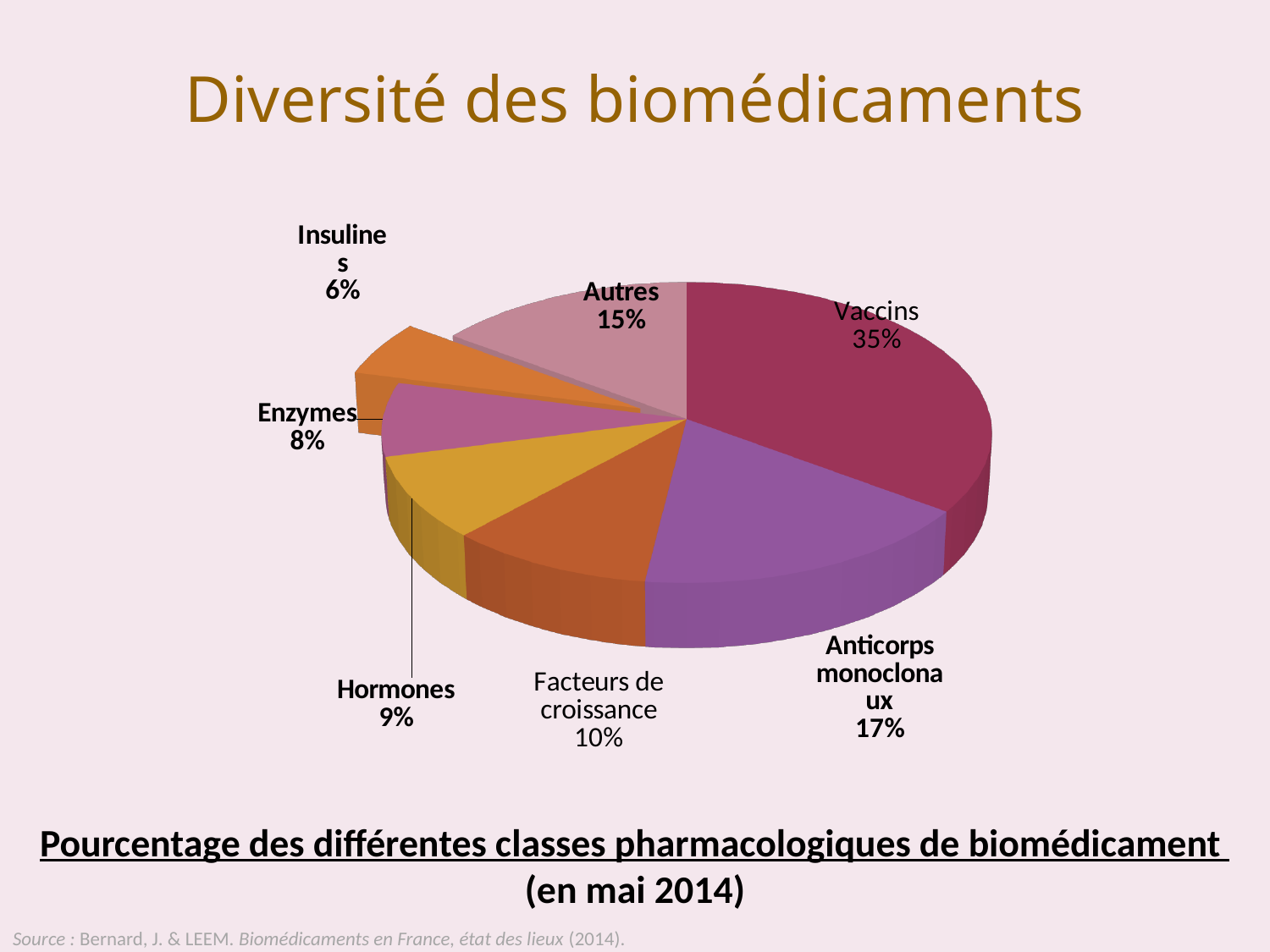
Which category has the largest share of the pie? Vaccins What is the value shown for Anticorps monoclonaux? 17% What is the difference in percentage points between Vaccins and Anticorps monoclonaux? 18 What is the value for Enzymes? 8% Which is larger, Autres or Facteurs de croissance? Autres What is the difference in percentage points between Hormones and Insulines? 3 How many categories are shown in the pie chart? 7 What percentage of the pie does Vaccins represent? 35% What percentage is shown for Hormones? 9% What kind of chart is shown on the slide? Pie chart Which category has the smallest share of the pie? Insulines